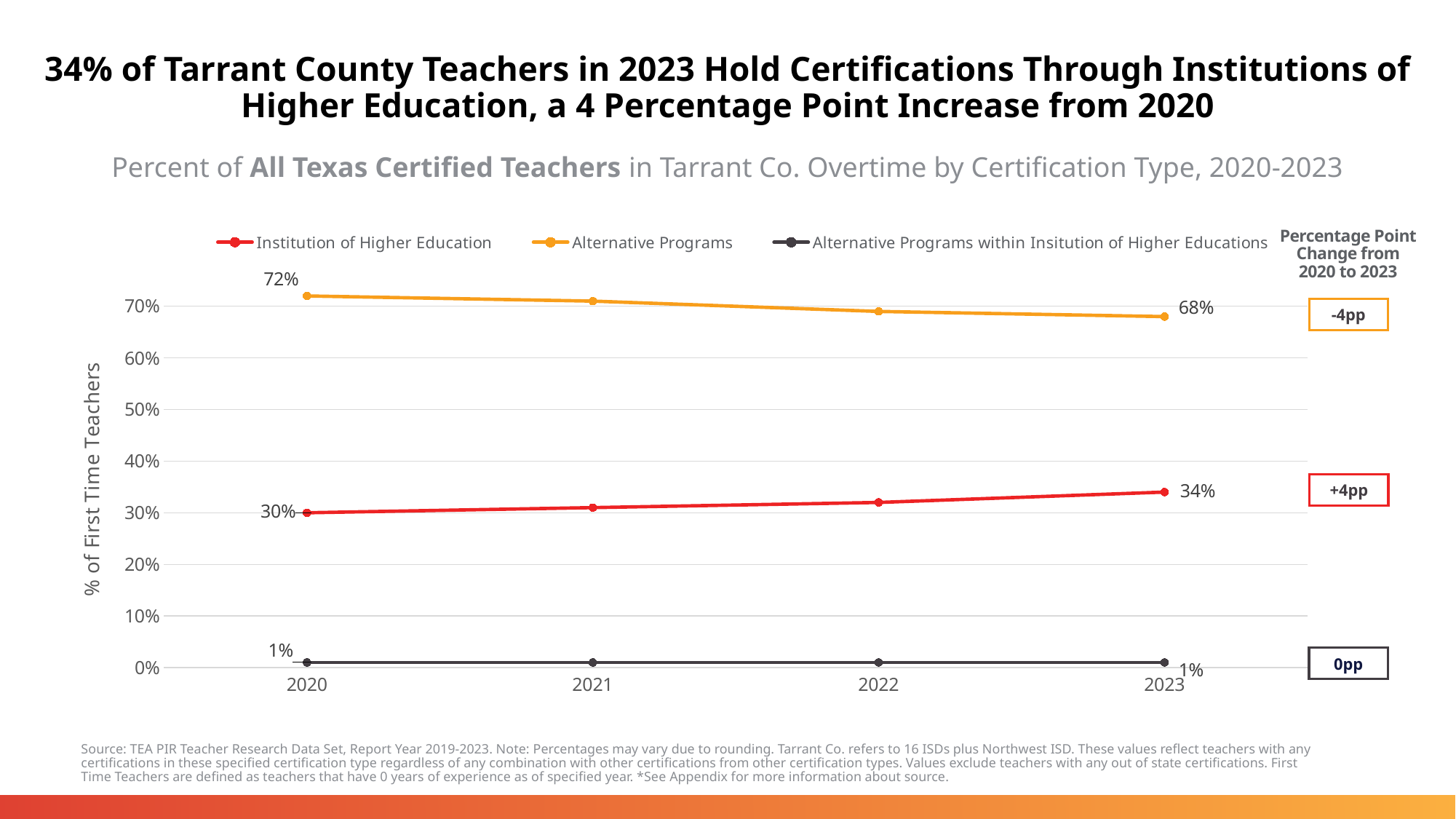
What kind of chart is shown on the slide? line chart Does the Institution of Higher Education line rise or fall from 2020 to 2023? rise How many series does the legend list? 3 How many years are shown on the x axis? 4 Which series has the highest value in 2023? Alternative Programs What is the value for Alternative Programs in 2020? 72% Which series has the lowest value in 2020? Alternative Programs within Insitution of Higher Educations What is the value for Institution of Higher Education in 2023? 34% What is the difference between the Alternative Programs value in 2020 and in 2023? 4 percentage points What is the value for Alternative Programs within Institution of Higher Educations in 2020? 1% What is the value for Alternative Programs in 2023? 68% Is the value for Institution of Higher Education in 2021 greater or less than 40%? less